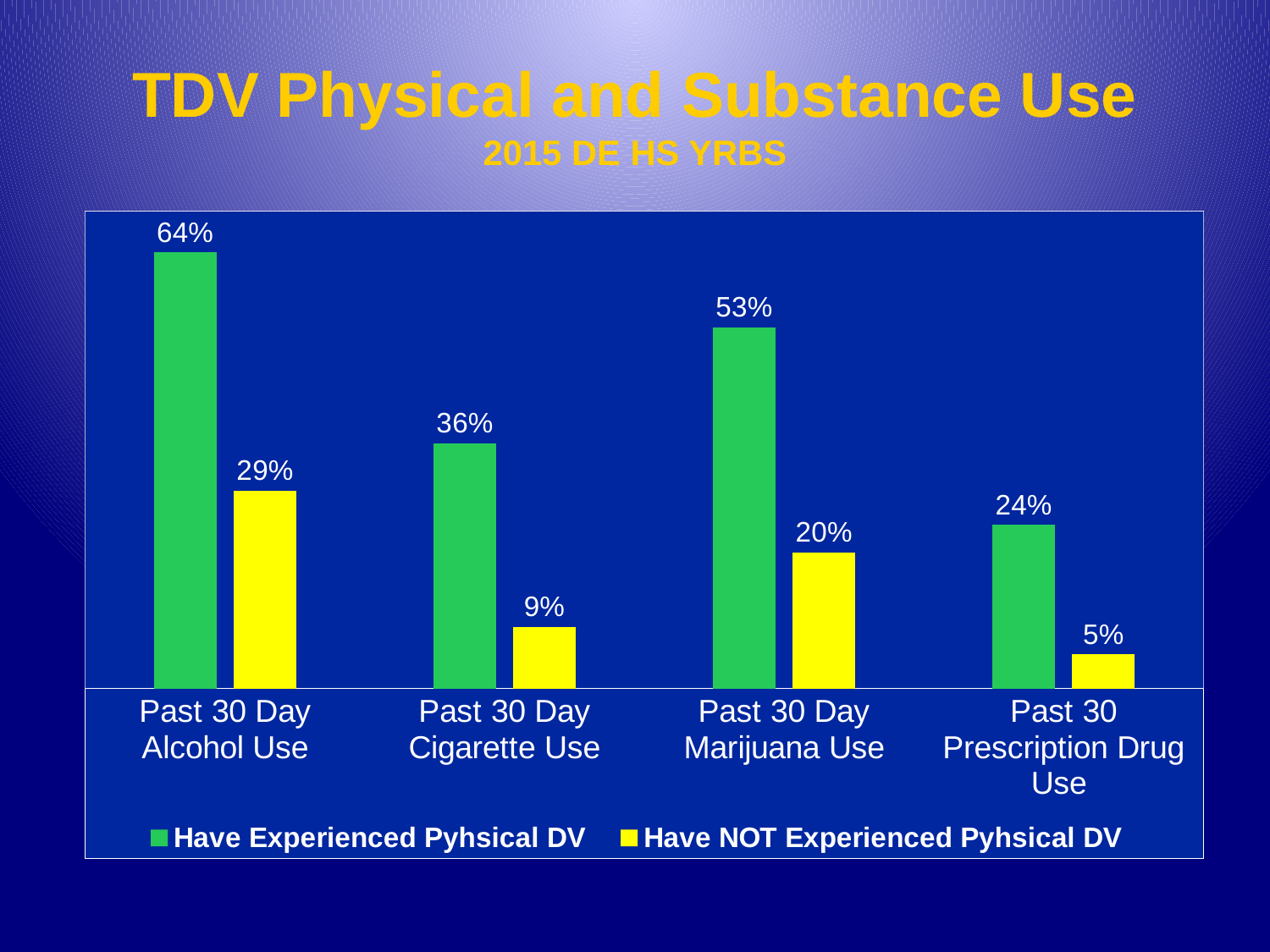
Which category has the lowest value for the Have NOT Experienced Physical DV series? Past 30 Day Prescription Drug Use What is the difference between the Have Experienced Physical DV and Have NOT Experienced Physical DV values for Past 30 Day Marijuana Use? 33% What kind of chart is shown on the slide? Bar chart Which category has the highest value for the Have Experienced Physical DV series? Past 30 Day Alcohol Use How many series does the legend list? 2 How many categories are shown on the x axis? 4 What is the value for Past 30 Day Cigarette Use among those who Have NOT Experienced Physical DV? 9% What is the value for Past 30 Day Prescription Drug Use among those who Have NOT Experienced Physical DV? 5% What is the value for Past 30 Day Alcohol Use among those who Have Experienced Physical DV? 64% What is the difference between the Have Experienced Physical DV and Have NOT Experienced Physical DV values for Past 30 Day Alcohol Use? 35% Which is larger: Past 30 Day Cigarette Use for Have Experienced Physical DV or Past 30 Day Prescription Drug Use for Have Experienced Physical DV? Past 30 Day Cigarette Use What is the value for Past 30 Day Marijuana Use among those who Have Experienced Physical DV? 53%